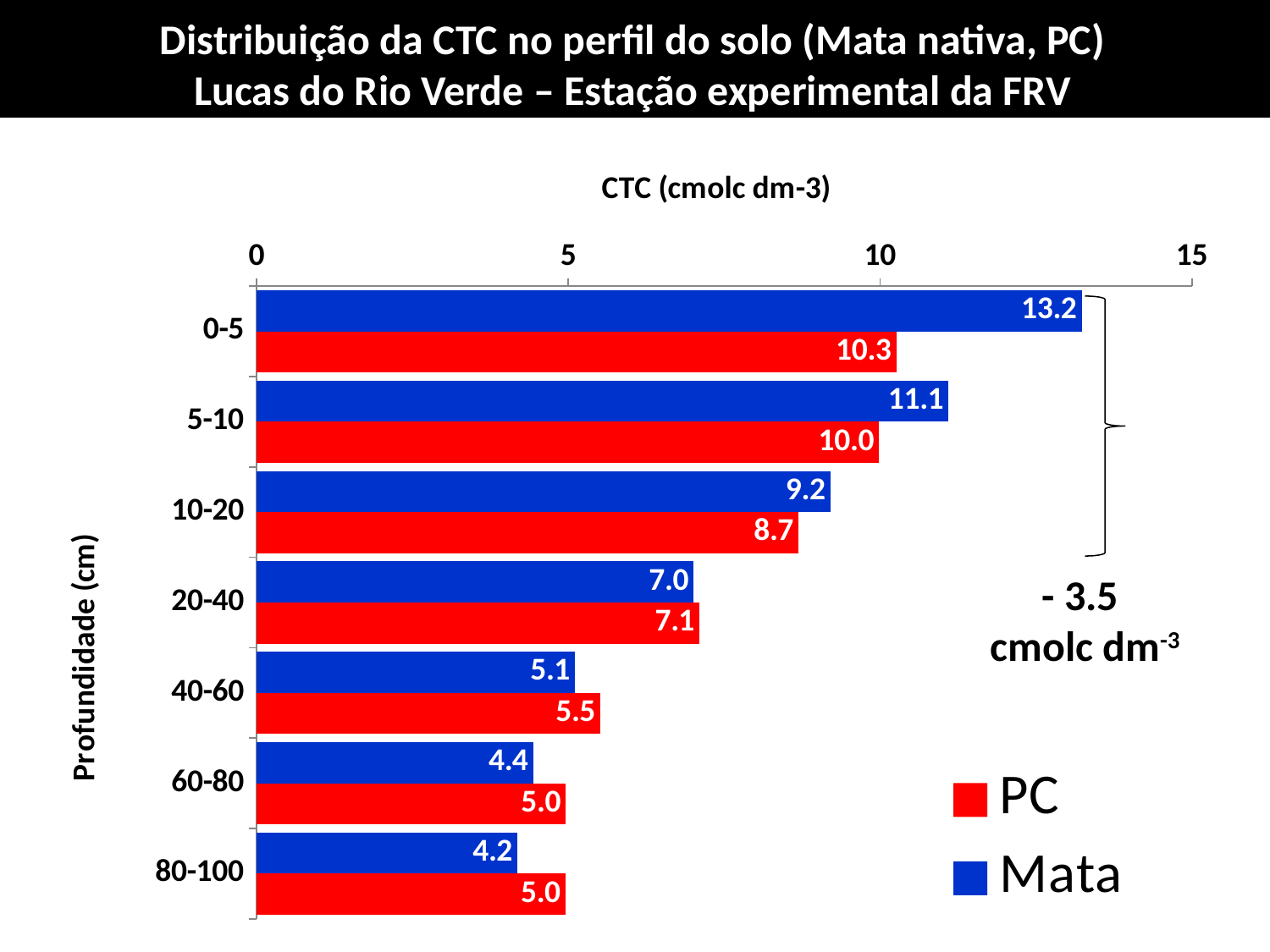
Is the Mata value at the 5-10 cm depth greater or less than 10? greater What is the difference between the Mata and PC values at the 0-5 cm depth? 2.9 Which depth has the lowest Mata CTC value? 80-100 At the 40-60 cm depth, which series has the larger CTC value, PC or Mata? PC What is the CTC value for Mata at the 0-5 cm depth? 13.2 What kind of chart is shown on the slide? bar chart How many depth categories are shown on the chart? 7 What is the CTC value for PC at the 80-100 cm depth? 5.0 What is the CTC value for PC at the 10-20 cm depth? 8.7 Which depth has the highest Mata CTC value? 0-5 How many series does the legend list? 2 What is the label of the vertical axis? Profundidade (cm)